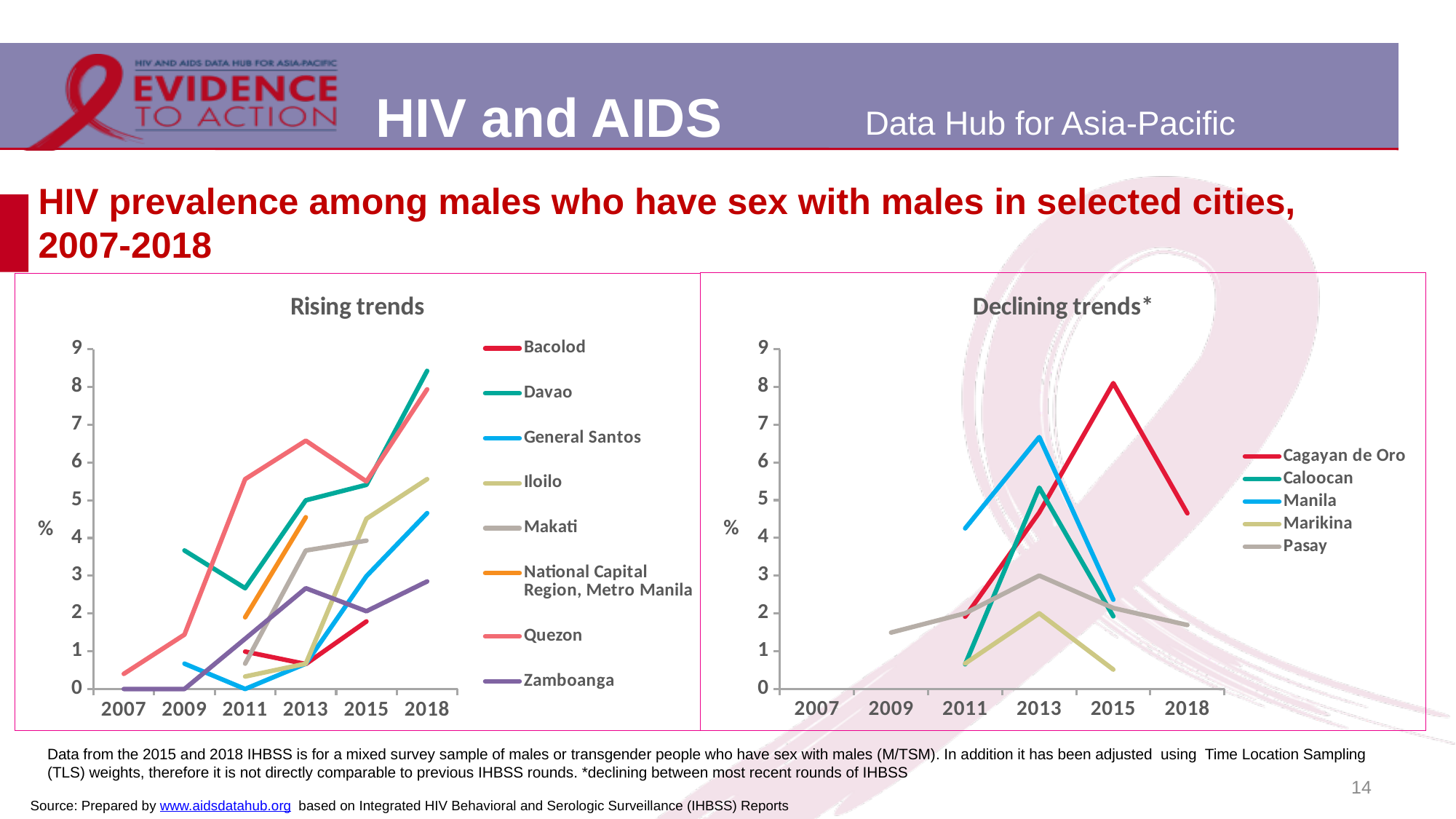
How many series does the legend of the "Rising trends" chart list? 8 In the "Declining trends*" chart, which series reaches the highest value? Cagayan de Oro In the "Declining trends*" chart, which is larger in 2013, Manila or Marikina? Manila In the "Declining trends*" chart, is the value for Cagayan de Oro in 2015 greater or less than 7? greater In the "Rising trends" chart, is the value for Davao in 2018 greater or less than 8? greater What is the title of the chart on the left side of the slide? Rising trends In the "Declining trends*" chart, does the value for Cagayan de Oro rise or fall from 2015 to 2018? fall How many years are shown on the x axis of the "Rising trends" chart? 6 What kind of chart is the "Rising trends" chart? line chart How many series does the legend of the "Declining trends*" chart list? 5 In the "Rising trends" chart, is the value for Quezon in 2013 greater or less than 6? greater